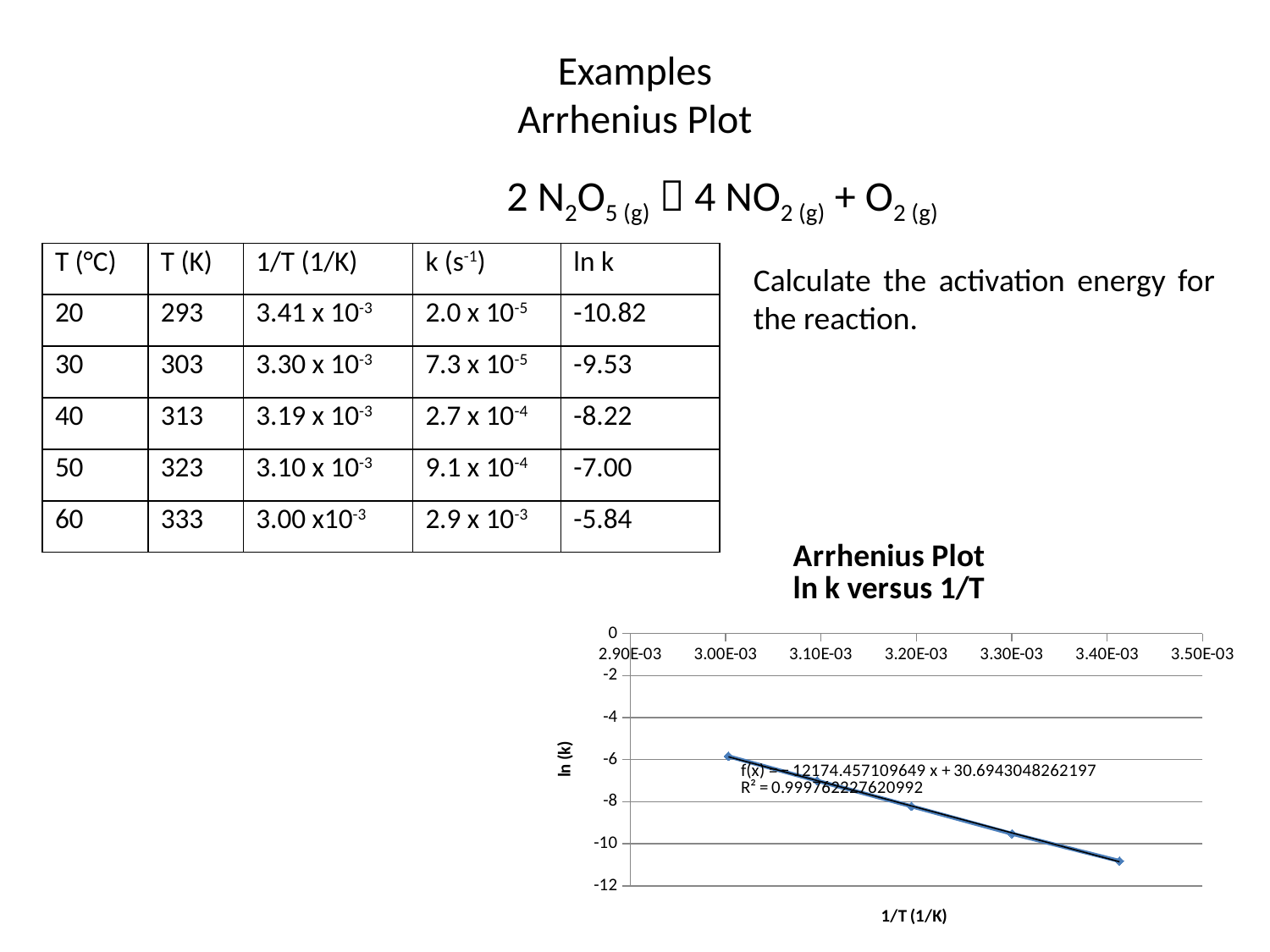
How many data points are plotted in the Arrhenius Plot chart? 5 Do the ln k values rise or fall as 1/T increases along the x axis? fall What kind of chart is shown on the slide? scatter chart Which has the larger plotted ln k value: the point at 1/T = 3.10E-03 or the point at 1/T = 3.30E-03? 3.10E-03 At which 1/T value is the plotted ln k highest? 3.00E-03 At which 1/T value is the plotted ln k lowest? 3.41E-03 Is the plotted ln k value at 1/T = 3.10E-03 greater or less than -8? greater Is the plotted ln k value at 1/T = 3.41E-03 greater or less than -10? less Is the plotted ln k value at 1/T = 3.30E-03 greater or less than -8? less What is the R² value shown for the trendline on the chart? 0.999762227620992 What is the title of the chart? Arrhenius Plot ln k versus 1/T What is the label on the x axis of the chart? 1/T (1/K)